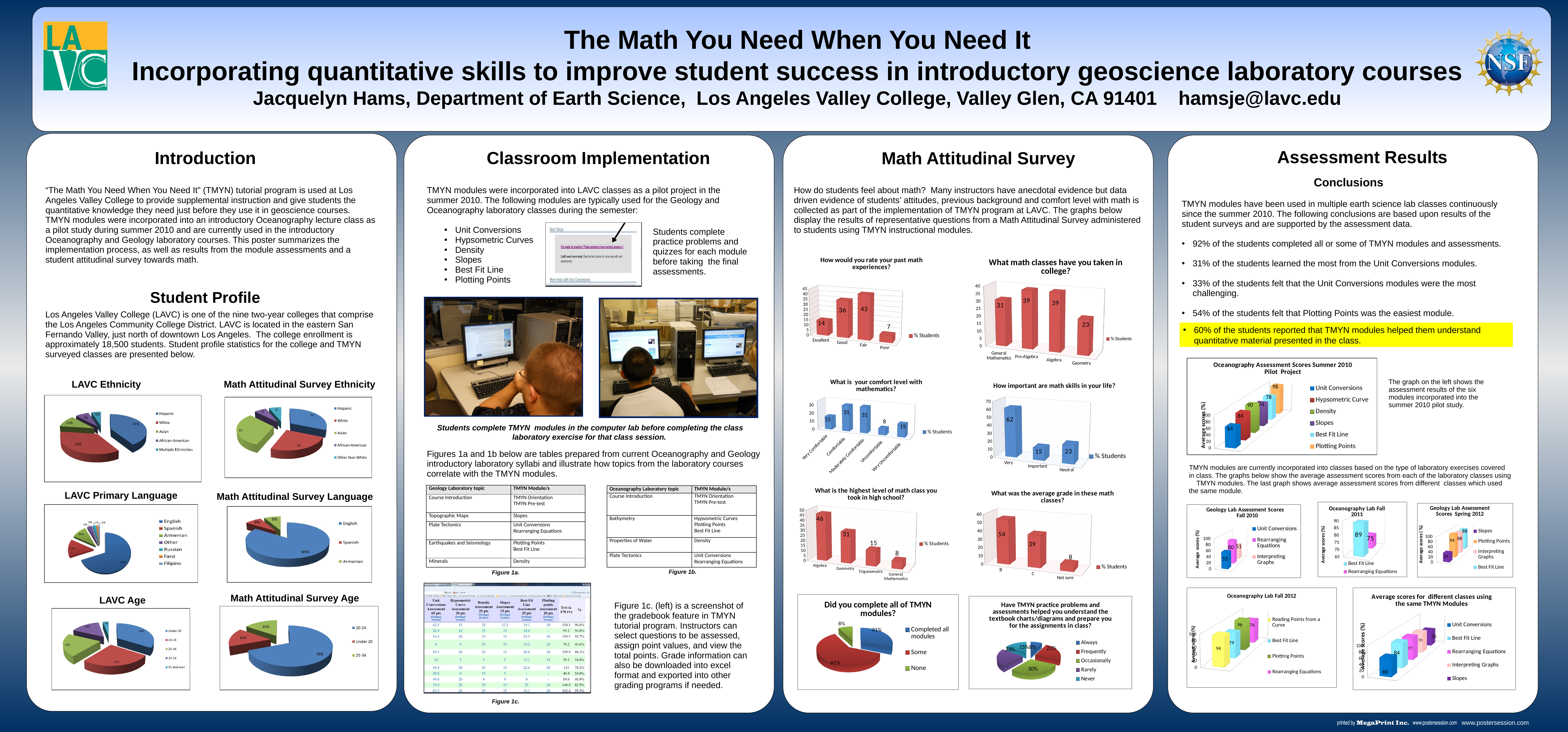
How many series does the legend of the chart 'Oceanography Lab Fall 2012' list? 4 In the chart 'Oceanography Assessment Scores Summer 2010 Pilot Project', which module has the highest average score? Plotting Points In the chart 'How would you rate your past math experiences?', which category has the lowest value? Poor What type of chart is 'Did you complete all of TMYN modules?' pie chart In the chart 'Oceanography Assessment Scores Summer 2010 Pilot Project', what is the average score for Unit Conversions? 64 In the chart 'How important are math skills in your life?', what is the difference between the values for Very and Neutral? 39 In the chart 'How would you rate your past math experiences?', what is the value for Fair? 43 In the chart 'What is your comfort level with mathematics?', how many categories are shown on the x axis? 5 In the chart 'What math classes have you taken in college?', what is the value for Geometry? 23 In the pie chart 'Did you complete all of TMYN modules?', what share of students completed Some of the modules? 61% In the chart 'What was the average grade in these math classes?', is the value for B larger or smaller than the value for C? larger In the chart 'What is the highest level of math class you took in high school?', which category has the highest value? Algebra